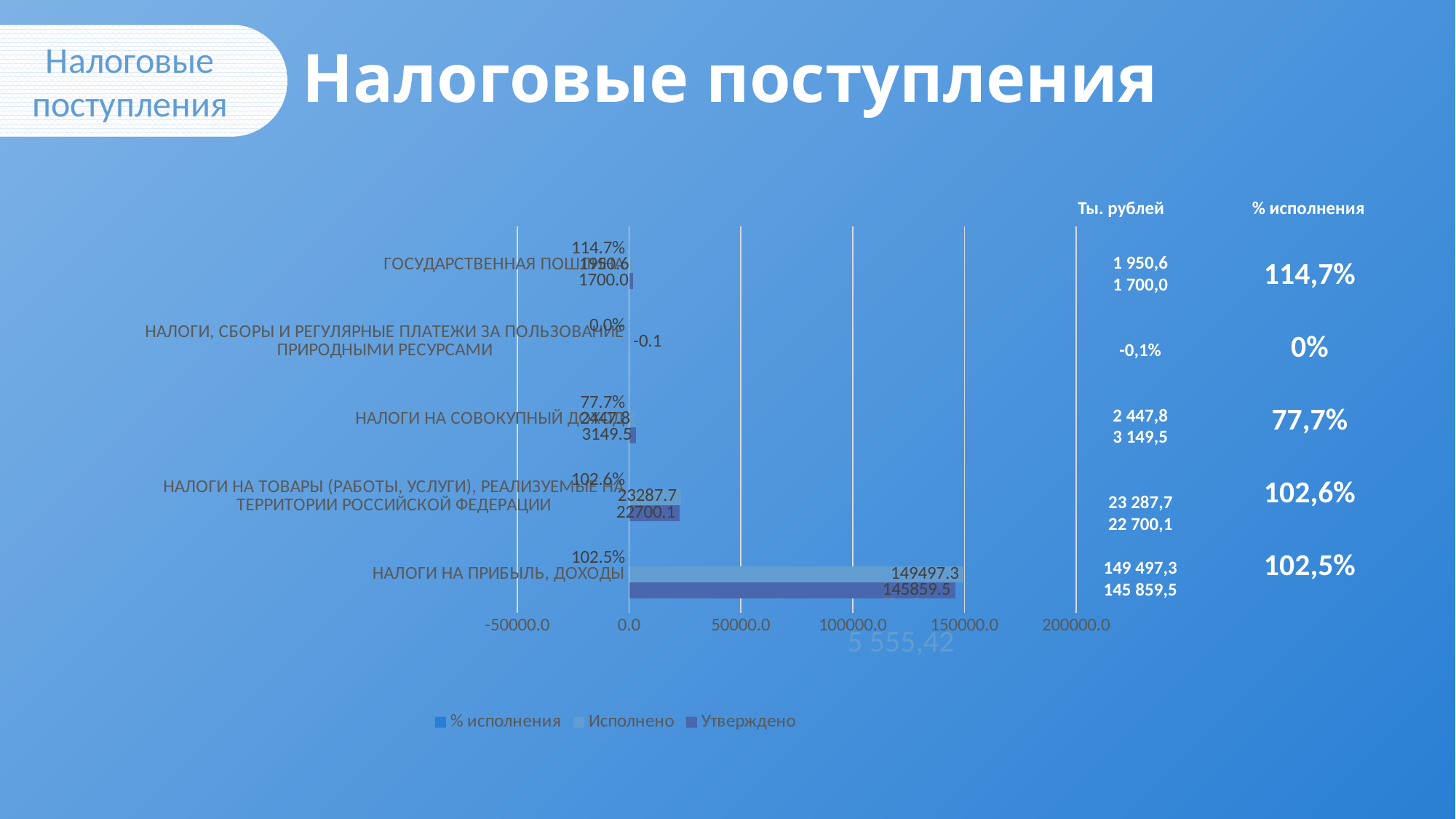
What is the Утверждено value for НАЛОГИ НА ТОВАРЫ (РАБОТЫ, УСЛУГИ), РЕАЛИЗУЕМЫЕ НА ТЕРРИТОРИИ РОССИЙСКОЙ ФЕДЕРАЦИИ? 22700.1 What % исполнения is shown for ГОСУДАРСТВЕННАЯ ПОШЛИНА? 114.7% What kind of chart is shown on the slide? bar chart How many categories are shown on the chart? 5 What is the Утверждено value for НАЛОГИ НА ПРИБЫЛЬ, ДОХОДЫ? 145859.5 What is the difference between the Исполнено and Утверждено values for НАЛОГИ НА ПРИБЫЛЬ, ДОХОДЫ? 3637.8 What is the Утверждено value for НАЛОГИ НА СОВОКУПНЫЙ ДОХОД? 3149.5 Which is larger for НАЛОГИ НА ТОВАРЫ (РАБОТЫ, УСЛУГИ), РЕАЛИЗУЕМЫЕ НА ТЕРРИТОРИИ РОССИЙСКОЙ ФЕДЕРАЦИИ: Исполнено or Утверждено? Исполнено Which category has the highest Исполнено value? НАЛОГИ НА ПРИБЫЛЬ, ДОХОДЫ How many series does the chart legend list? 3 Is the Исполнено value for НАЛОГИ НА ПРИБЫЛЬ, ДОХОДЫ greater or less than 100000.0? greater What is the Исполнено value for НАЛОГИ НА ПРИБЫЛЬ, ДОХОДЫ? 149497.3